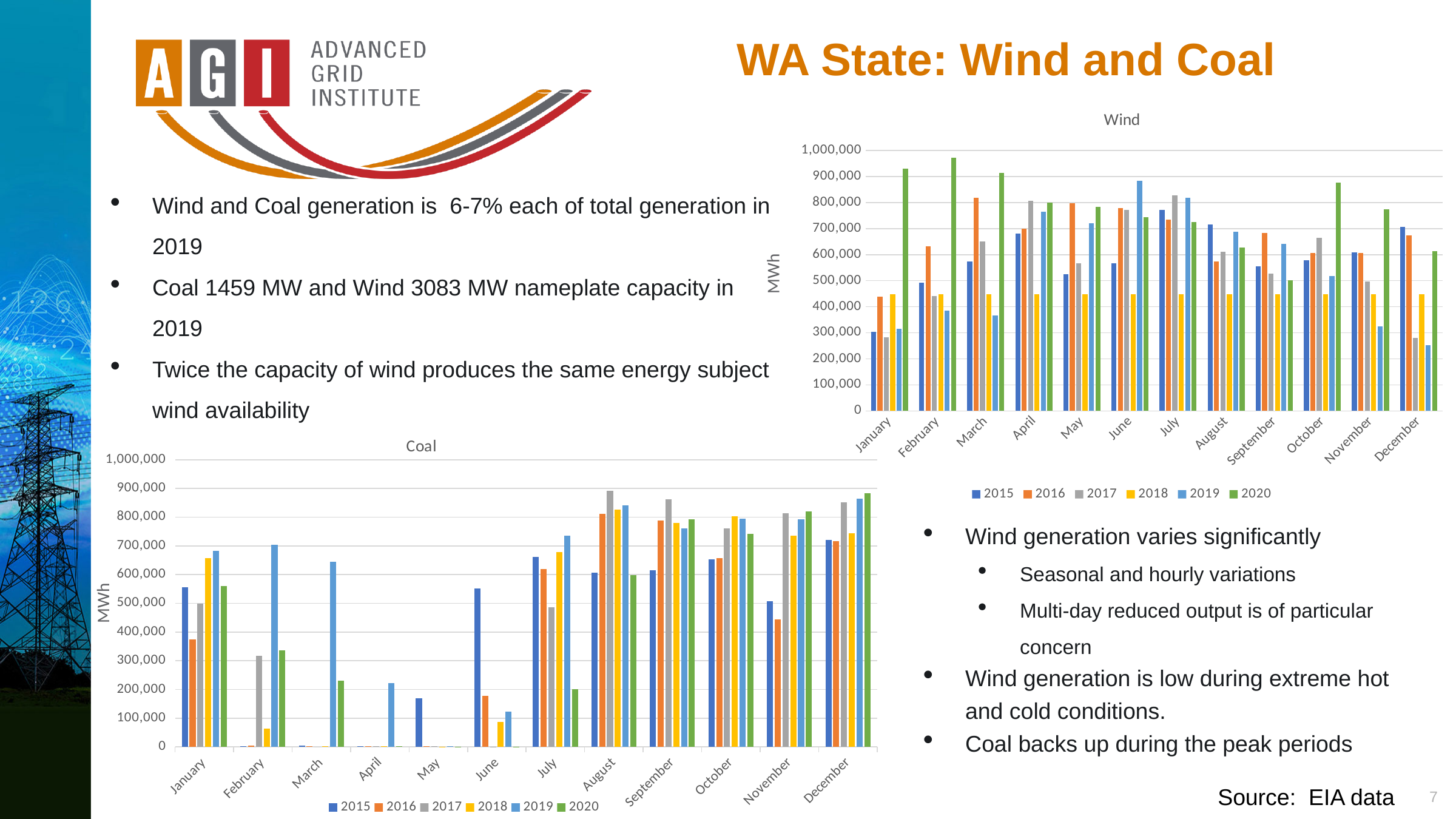
In the Wind chart, is the value for 2015 in January greater or less than 400,000? less How many series does the legend of the Coal chart list? 6 In the Coal chart, which is larger in January: 2015 or 2016? 2015 What kind of chart is the Wind chart? bar chart What is the y-axis label on the Coal chart? MWh In the Wind chart, which is larger in January: 2015 or 2020? 2020 How many months are shown on the x axis of the Wind chart? 12 In the Wind chart, is the value for 2019 in June greater or less than 800,000? greater In the Coal chart, is the value for 2015 in May greater or less than 200,000? less